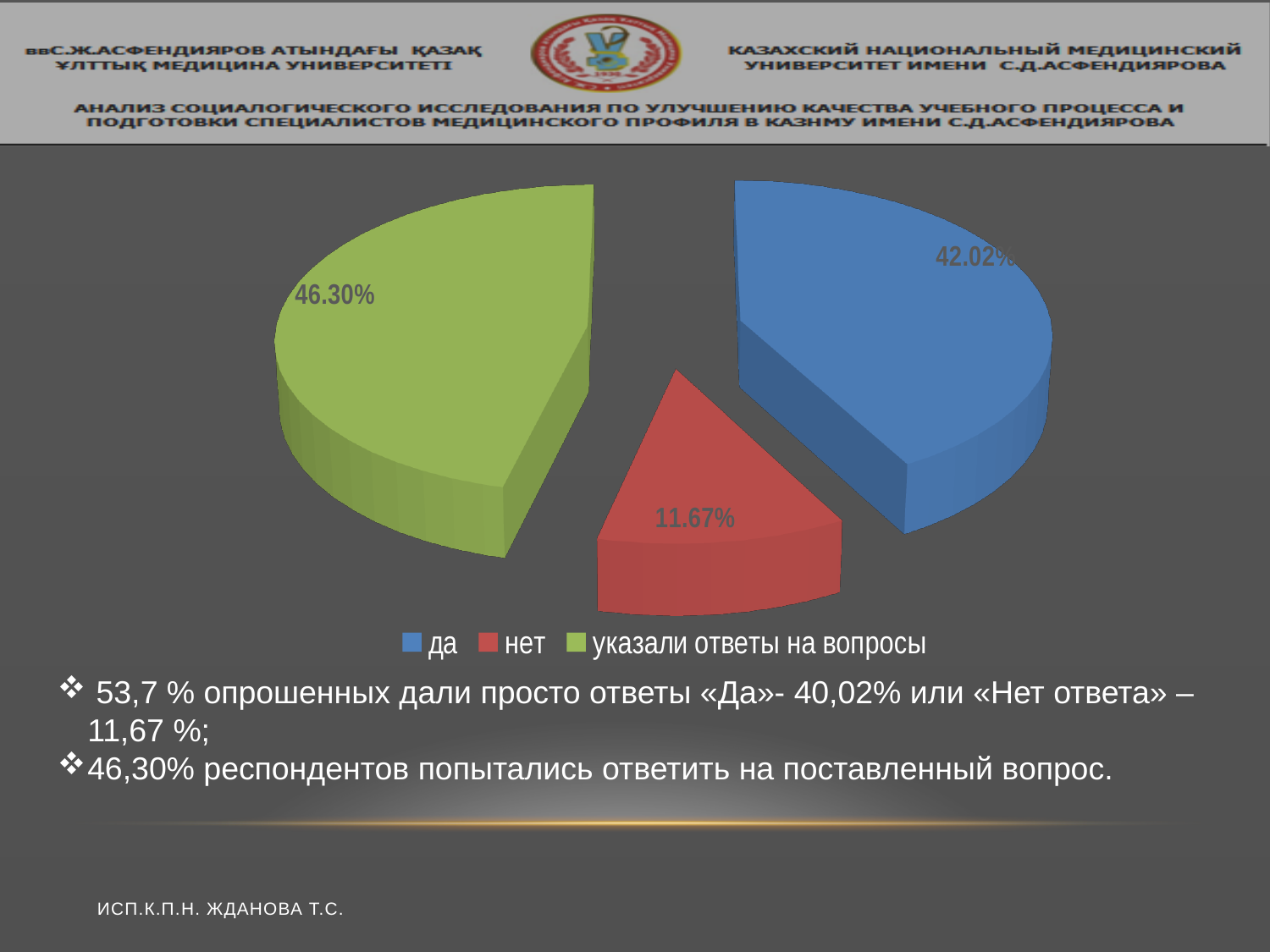
Which is larger in the pie chart, the "да" slice or the "нет" slice? да What percentage of the pie is labelled for the "да" slice? 42.02% Which slice of the pie chart is the largest? указали ответы на вопросы What is the difference between the "да" slice and the "нет" slice? 30.35% What colour is the "нет" slice in the pie chart? red What kind of chart is shown on the slide? pie chart What percentage of the pie is labelled for the "нет" slice? 11.67% How many slices does the pie chart have? 3 What percentage of the pie is labelled for the "указали ответы на вопросы" slice? 46.30% Which slice of the pie chart is the smallest? нет What is the difference between the "указали ответы на вопросы" slice and the "да" slice? 4.28% How many entries does the legend of the pie chart list? 3